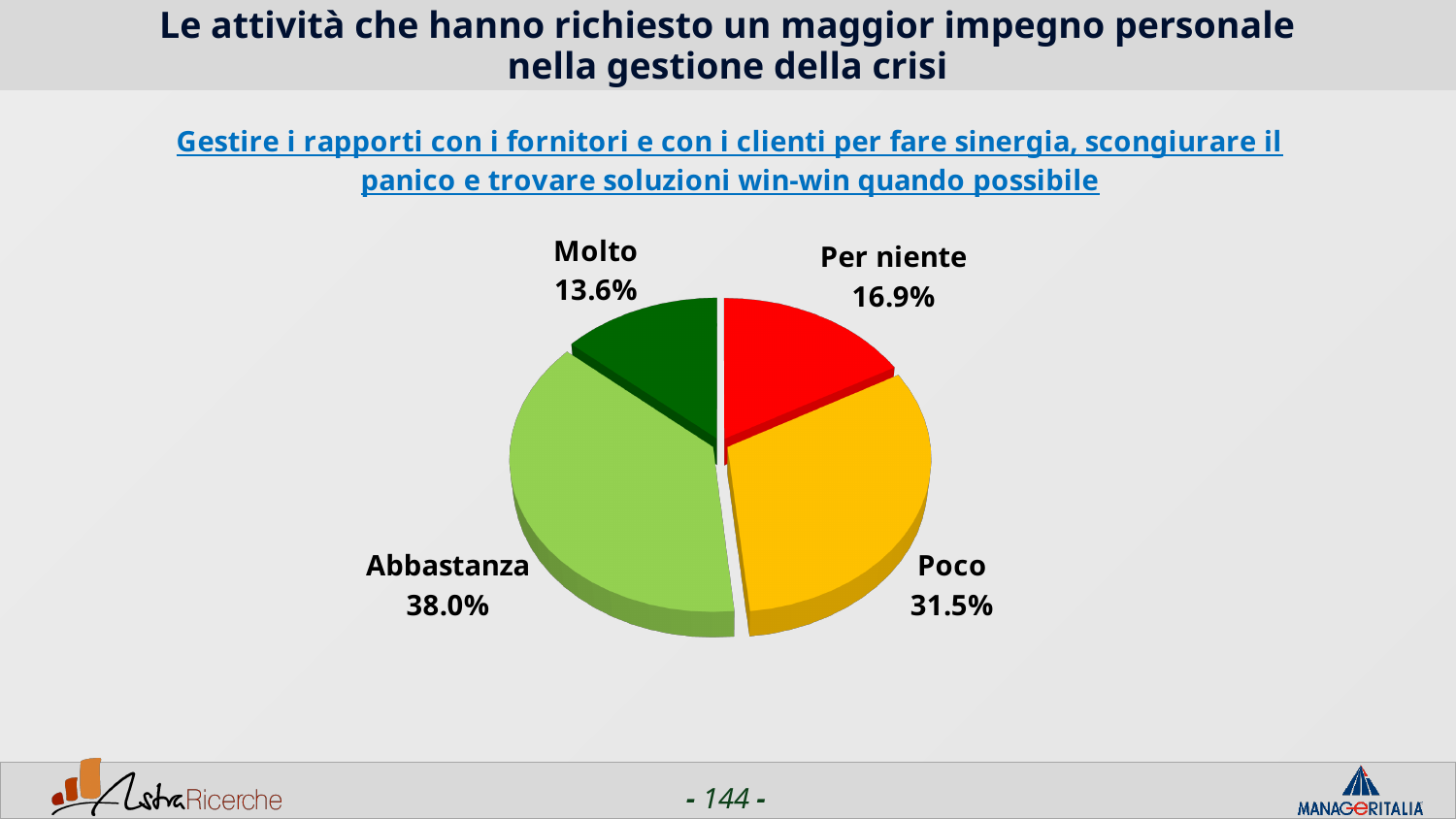
What is the value for "Poco"? 31.5% What is the difference between the values for "Abbastanza" and "Poco"? 6.5% Which category has the smallest share of the pie? Molto What is the value for "Per niente"? 16.9% What kind of chart is shown on the slide? pie chart How many slices does the pie chart have? 4 Which is larger, the value for "Poco" or the value for "Per niente"? Poco What is the value for "Molto"? 13.6% What is the value for "Abbastanza"? 38.0% Which category has the largest share of the pie? Abbastanza What is the difference between the values for "Per niente" and "Molto"? 3.3% What colour is the "Per niente" slice? red